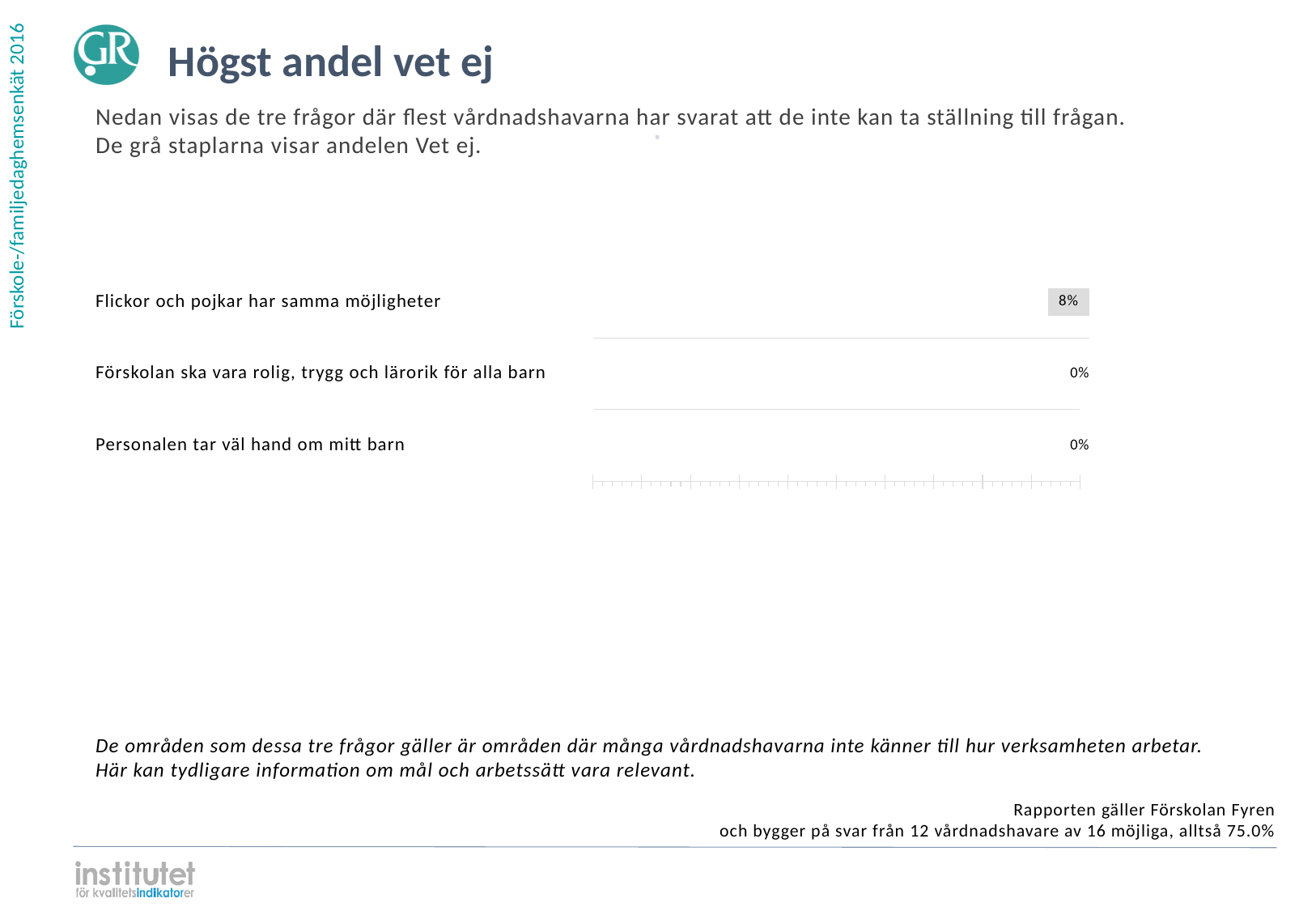
How many questions (categories) are shown in the chart? 3 What is the title of the slide containing the chart? Högst andel vet ej What colour are the bars showing the Vet ej share? Grey Which has a larger Vet ej share: "Flickor och pojkar har samma möjligheter" or "Förskolan ska vara rolig, trygg och lärorik för alla barn"? Flickor och pojkar har samma möjligheter What is the difference between the Vet ej share for "Flickor och pojkar har samma möjligheter" and for "Personalen tar väl hand om mitt barn"? 8% How many of the three questions have a Vet ej share of 0%? 2 What kind of chart is shown on the slide? Bar chart What is the Vet ej share for "Personalen tar väl hand om mitt barn"? 0% Which question has the highest Vet ej share? Flickor och pojkar har samma möjligheter What is the Vet ej share for "Flickor och pojkar har samma möjligheter"? 8% What is the Vet ej share for "Förskolan ska vara rolig, trygg och lärorik för alla barn"? 0%